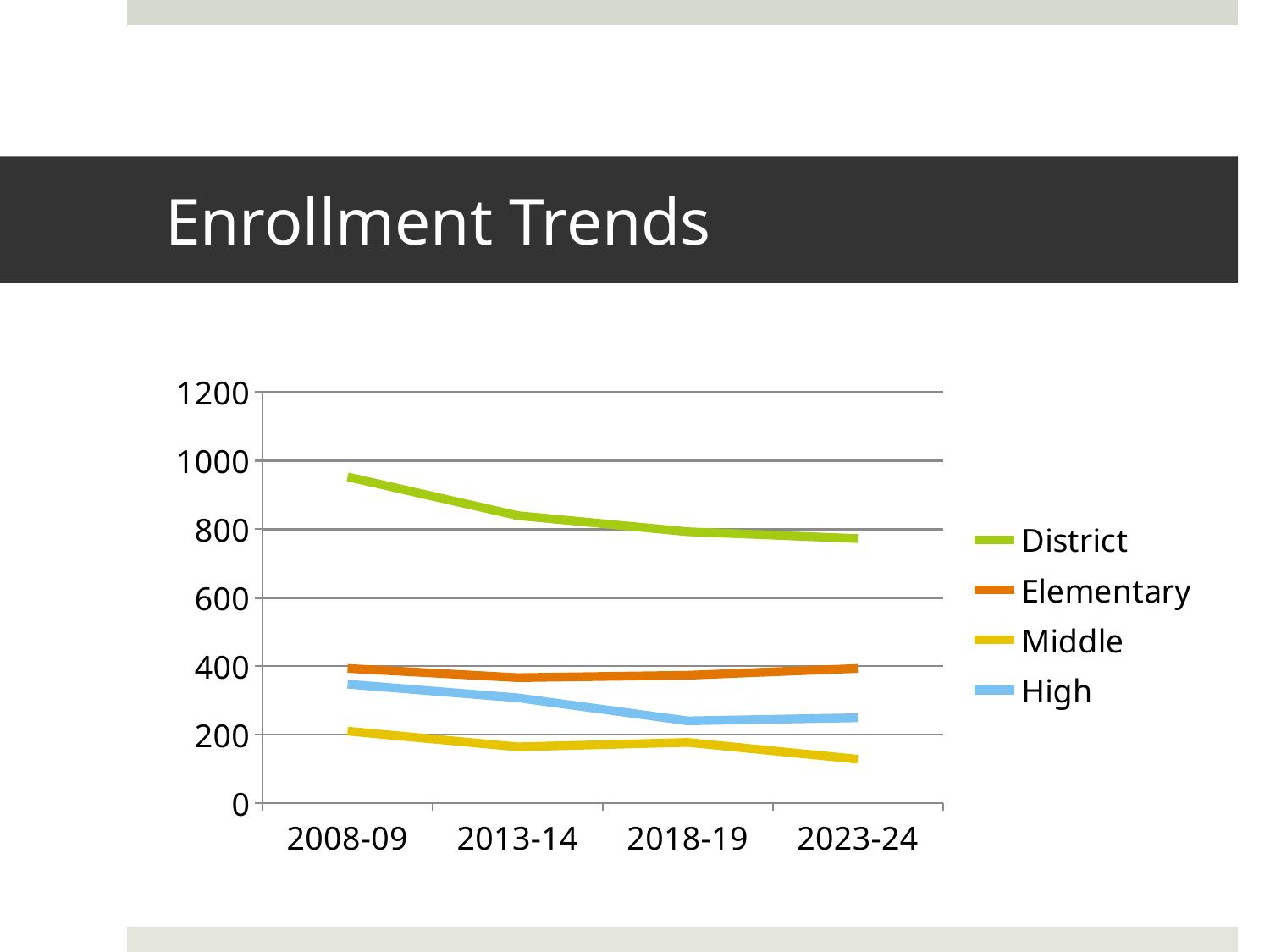
Which series has the lowest value in 2008-09? Middle Is the High value for 2008-09 greater or less than 400? less What kind of chart is shown on the slide? line chart In 2018-19, which is larger, the High value or the Middle value? High How many series does the legend list? 4 Is the District value for 2008-09 greater or less than 800? greater What is the title of the slide containing the chart? Enrollment Trends In which school year is the Middle value lowest? 2023-24 Does the District line rise or fall from 2008-09 to 2023-24? fall Which series has the highest value in 2023-24? District Is the Middle value for 2023-24 greater or less than 200? less How many school years are shown on the x axis? 4